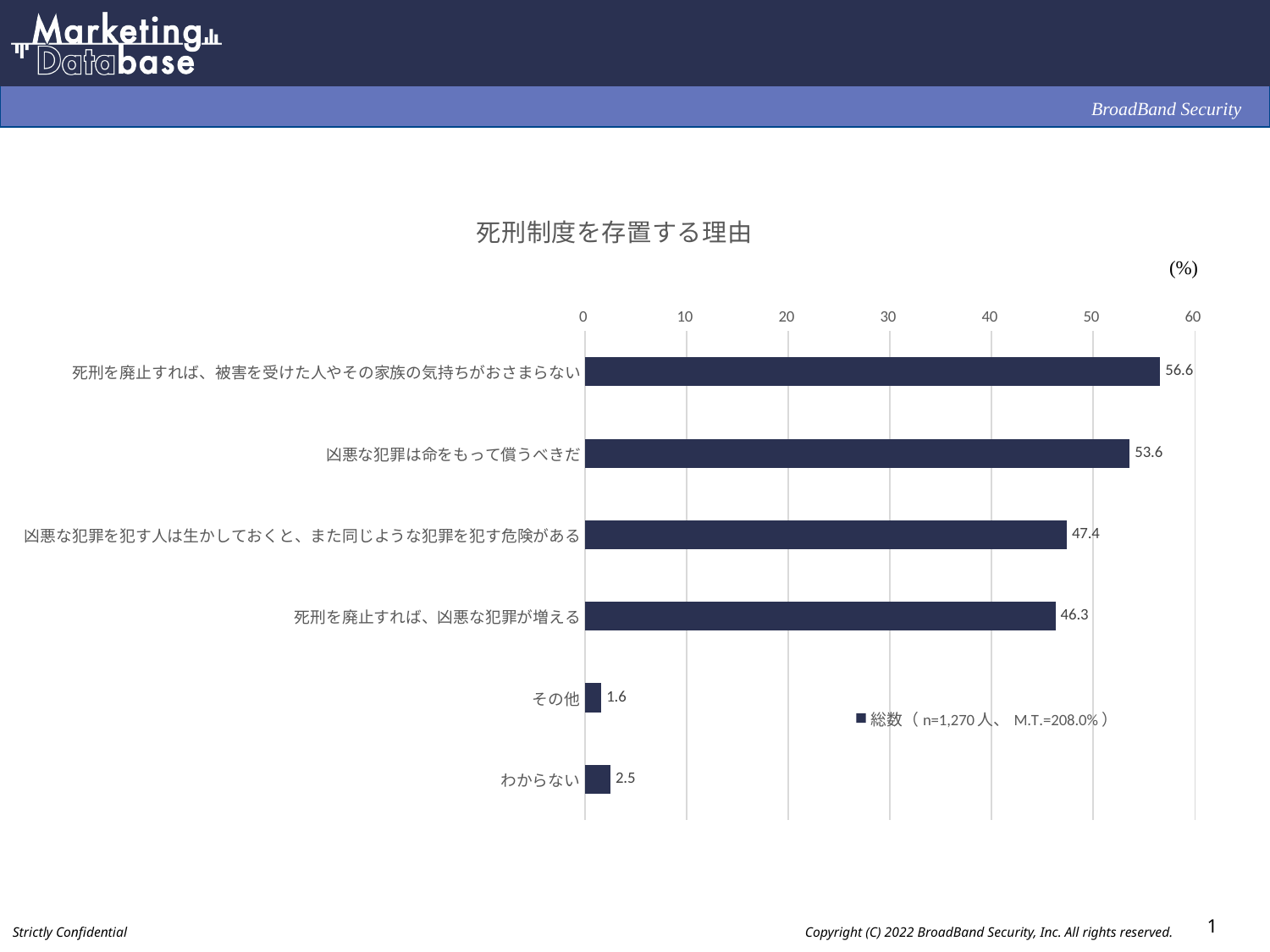
Which category has the highest value? 死刑を廃止すれば、被害を受けた人やその家族の気持ちがおさまらない What is the title of the chart? 死刑制度を存置する理由 Which is larger, the value for 「その他」 or the value for 「わからない」? わからない What kind of chart is shown on the slide? bar chart What is the difference between the values for 「凶悪な犯罪は命をもって償うべきだ」 and 「凶悪な犯罪を犯す人は生かしておくと、また同じような犯罪を犯す危険がある」? 6.2 What is the value for 「わからない」? 2.5 What is the value for 「死刑を廃止すれば、被害を受けた人やその家族の気持ちがおさまらない」? 56.6 What is the value for 「凶悪な犯罪は命をもって償うべきだ」? 53.6 How many categories are shown in the chart? 6 Is the value for 「凶悪な犯罪を犯す人は生かしておくと、また同じような犯罪を犯す危険がある」 greater or less than 40? greater What is the value for 「死刑を廃止すれば、凶悪な犯罪が増える」? 46.3 Which category has the lowest value? その他